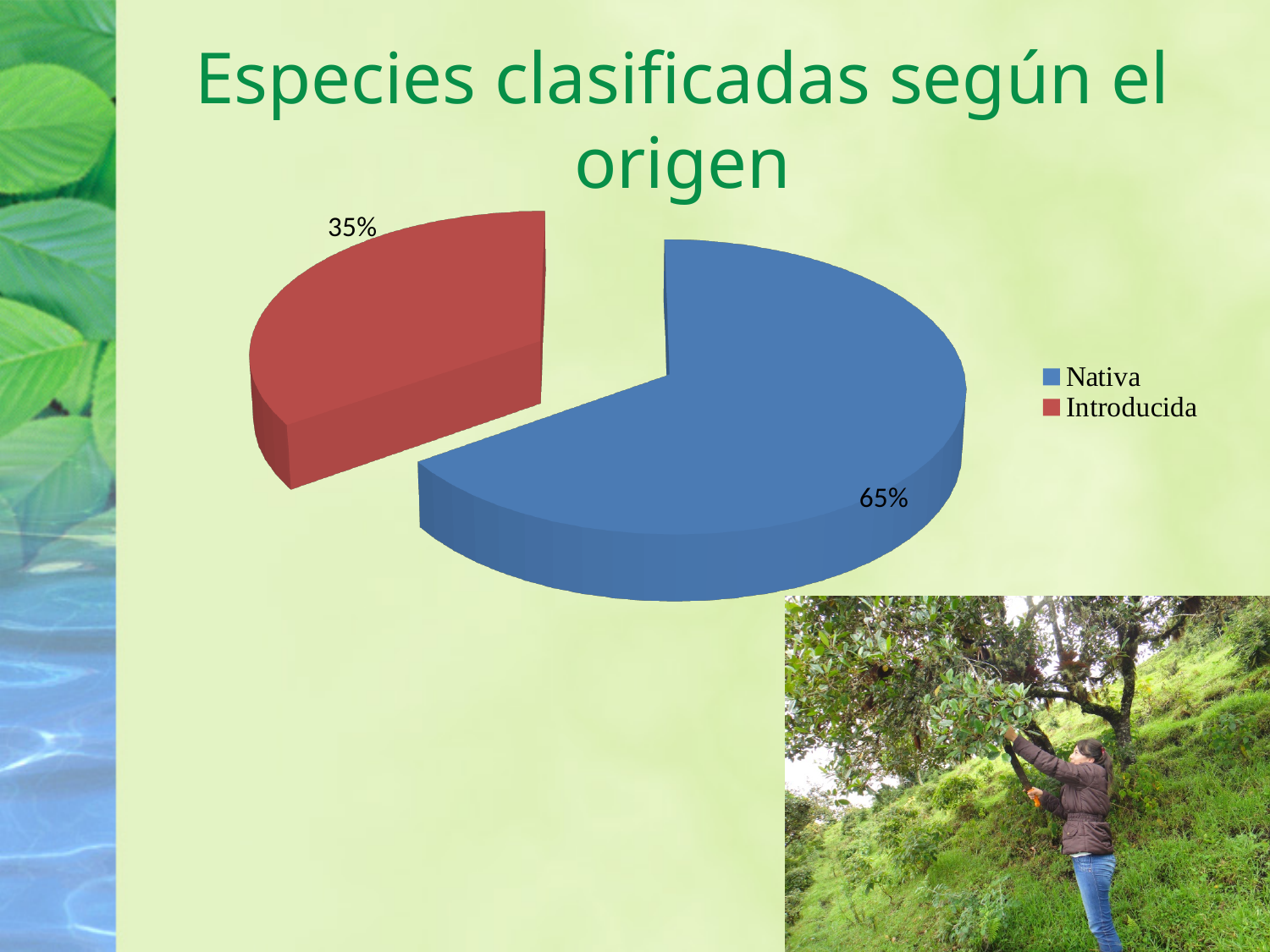
Which category has the largest slice of the pie? Nativa Which category has the smallest slice of the pie? Introducida What share of the pie does Introducida represent? 35% What share of the pie does Nativa represent? 65% Which is larger, the Nativa slice or the Introducida slice? Nativa What kind of chart is shown on the slide? Pie chart What is the difference in percentage points between the Nativa and Introducida slices? 30% How many categories are shown in the pie chart? 2 What is the title of the slide containing the chart? Especies clasificadas según el origen What colour is the Introducida slice in the pie chart? Red Is the value for Introducida greater or less than 50%? less